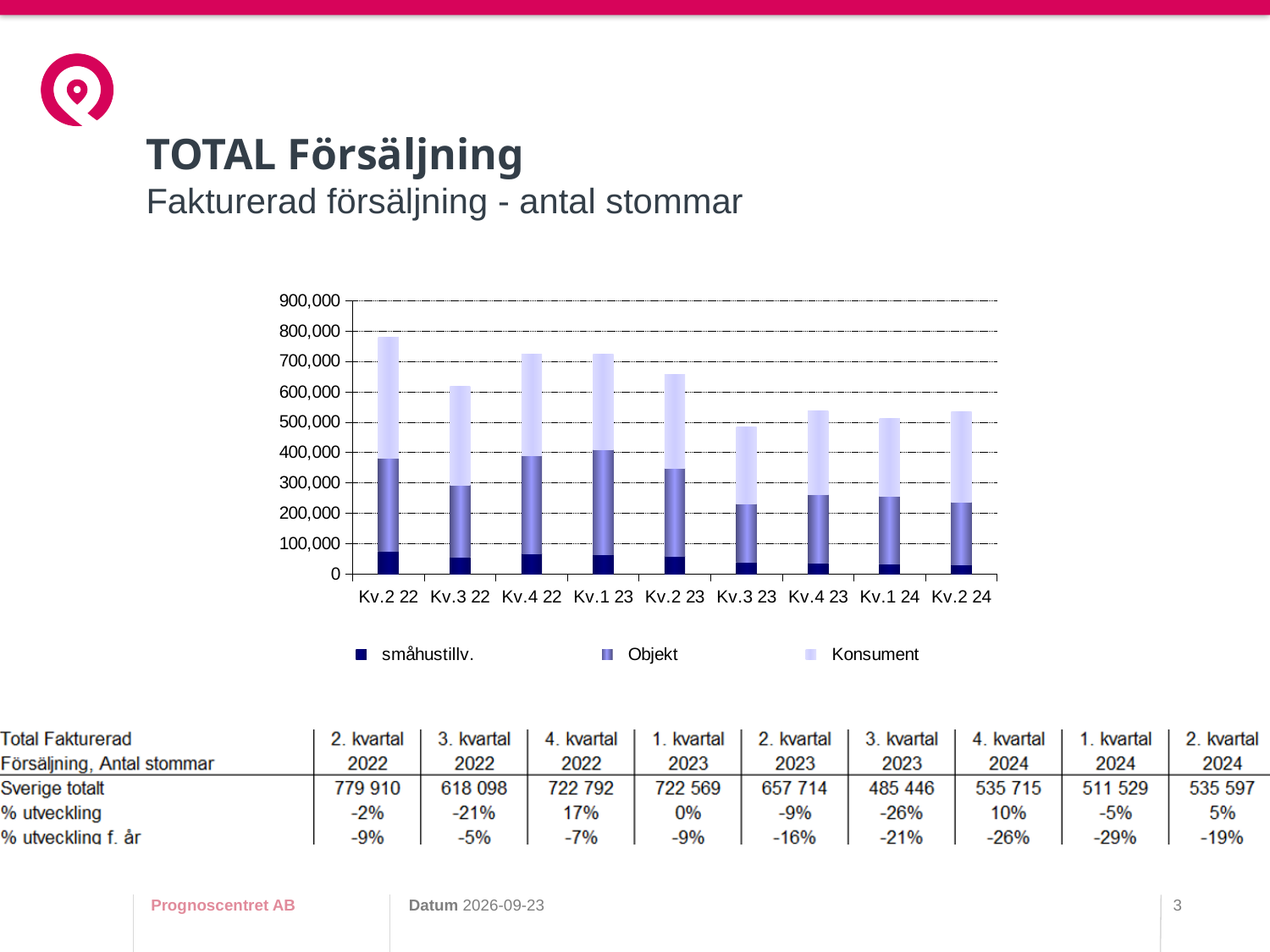
Is the total stacked bar for Kv.3 23 greater or less than 500,000? less Is the total stacked bar for Kv.2 22 greater or less than 700,000? greater According to the table below the chart, what is the Sverige totalt value for 3. kvartal 2023? 485 446 Do the total stacked bars generally rise or fall from Kv.2 22 to Kv.2 24? fall Which series are listed in the chart legend? småhustillv., Objekt, Konsument According to the table below the chart, what is the difference between Sverige totalt for 2. kvartal 2022 and 3. kvartal 2022? 161 812 How many series does the chart legend list? 3 What kind of chart is shown on the slide? Stacked bar chart Which quarter has the lowest total stacked bar? Kv.3 23 How many quarters are shown on the x axis of the chart? 9 Which quarter has the larger total stacked bar, Kv.3 22 or Kv.4 22? Kv.4 22 Which quarter has the highest total stacked bar? Kv.2 22